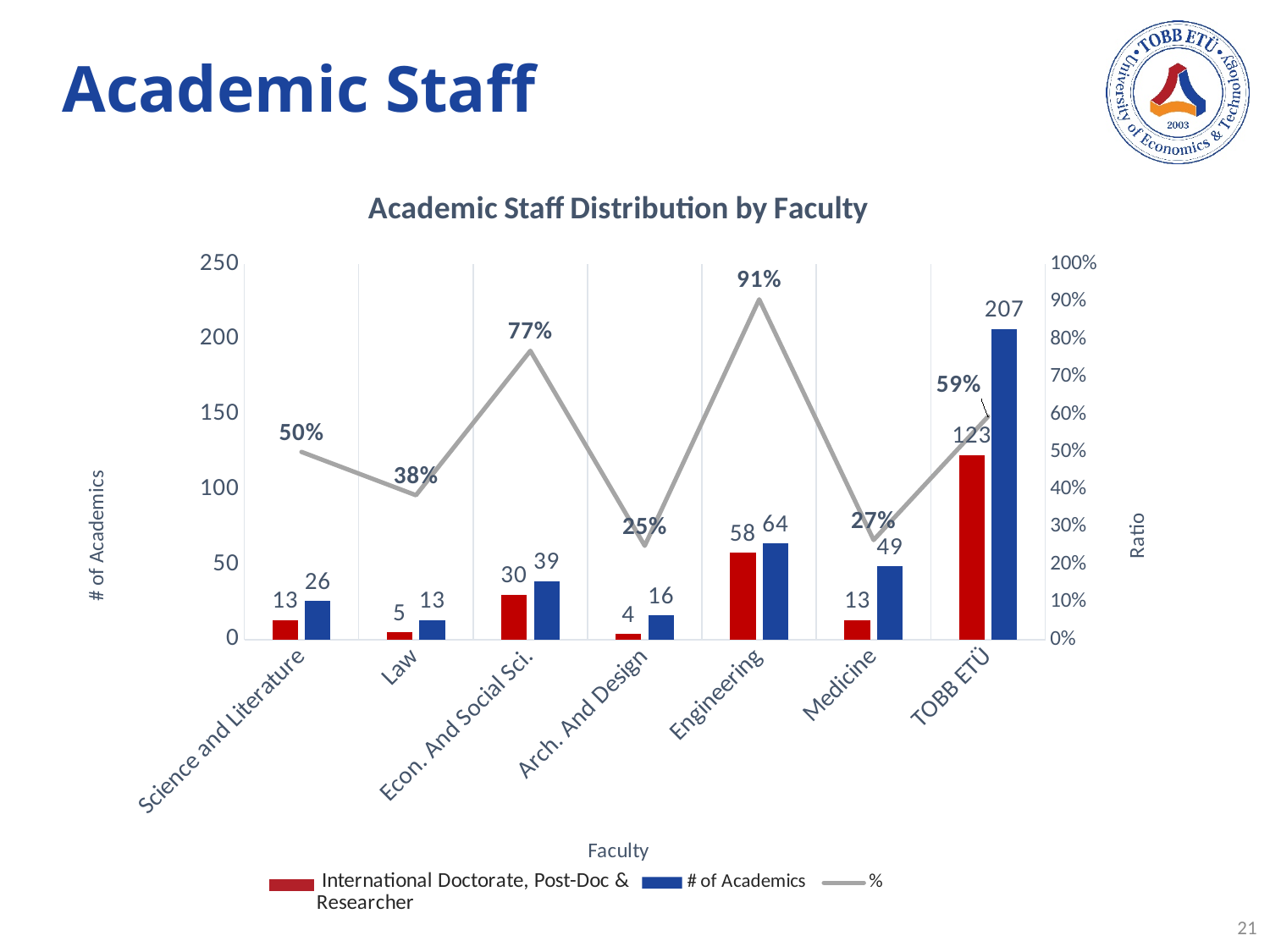
What is the value of # of Academics for Engineering? 64 Which category has the lowest International Doctorate, Post-Doc & Researcher value? Arch. And Design Which faculty has the highest % value? Engineering What is the title of the chart? Academic Staff Distribution by Faculty Which is larger, the # of Academics for Law or for Arch. And Design? Arch. And Design What is the % value for TOBB ETÜ? 59% How many faculty categories are shown on the x axis? 7 How many series does the legend list? 3 What percentage is shown for Arch. And Design on the % line? 25% What is the difference between # of Academics and International Doctorate, Post-Doc & Researcher for Medicine? 36 What is the International Doctorate, Post-Doc & Researcher value for Econ. And Social Sci.? 30 What kind of chart is used for the # of Academics series? Bar chart